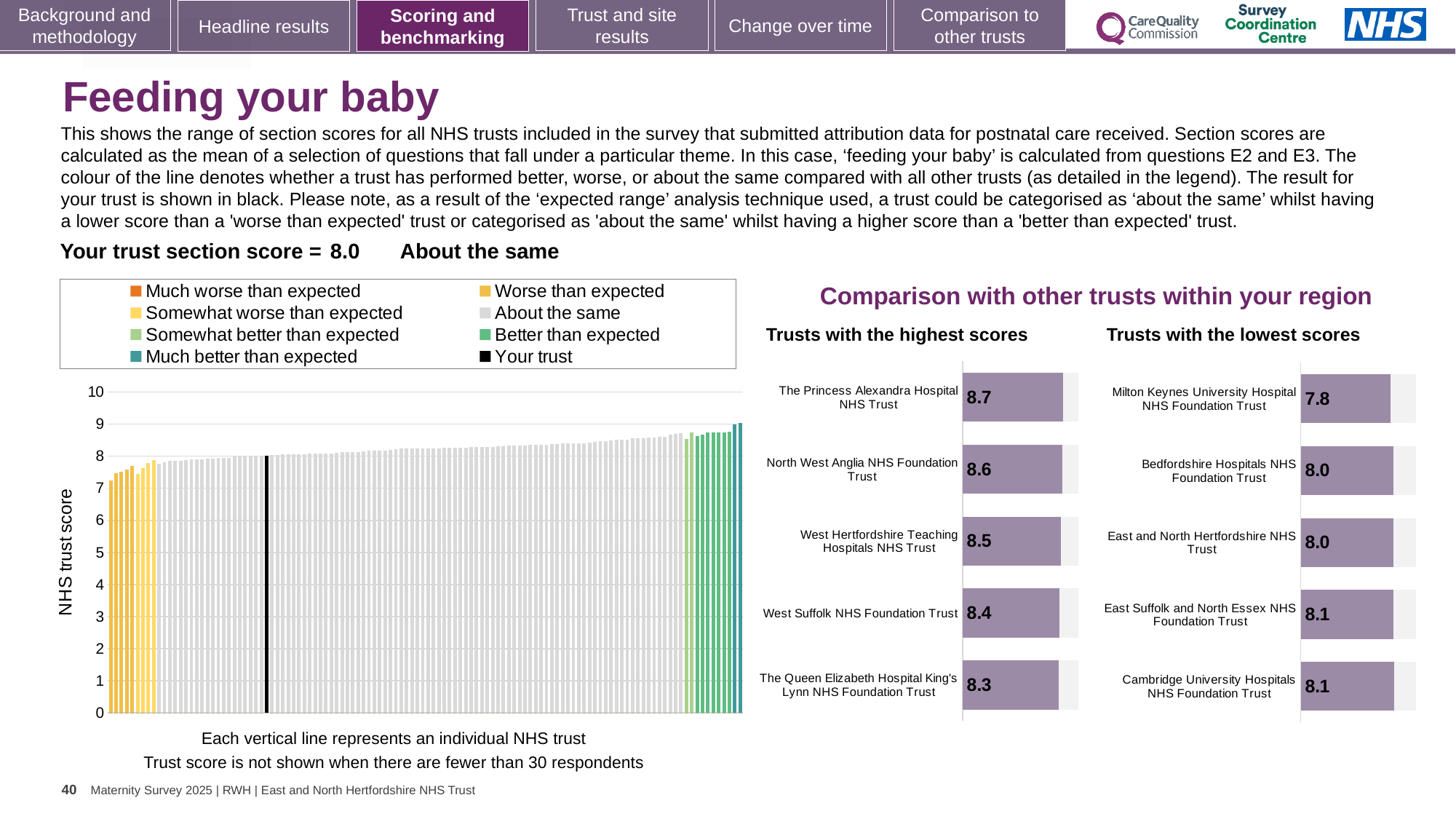
What kind of chart is the NHS trust score chart on the left of the slide? Bar chart In the NHS trust score chart on the left, do the bar heights rise or fall from left to right? Rise In the 'Trusts with the highest scores' chart, what is the difference between the scores of The Princess Alexandra Hospital NHS Trust and The Queen Elizabeth Hospital King's Lynn NHS Foundation Trust? 0.4 How many trusts are listed in the 'Trusts with the lowest scores' chart? 5 In the 'Trusts with the lowest scores' chart, which trust has the lowest score? Milton Keynes University Hospital NHS Foundation Trust In the 'Trusts with the highest scores' chart, what is the score for The Princess Alexandra Hospital NHS Trust? 8.7 In the 'Trusts with the lowest scores' chart, what is the difference between the scores of Cambridge University Hospitals NHS Foundation Trust and Milton Keynes University Hospital NHS Foundation Trust? 0.3 In the NHS trust score chart on the left, is the value of the black 'Your trust' bar greater or less than 5? greater How many entries does the legend of the NHS trust score chart list? 8 In the 'Trusts with the highest scores' chart, which has the higher score: North West Anglia NHS Foundation Trust or West Suffolk NHS Foundation Trust? North West Anglia NHS Foundation Trust In the 'Trusts with the highest scores' chart, which trust has the lowest score shown? The Queen Elizabeth Hospital King's Lynn NHS Foundation Trust In the 'Trusts with the lowest scores' chart, what is the score for Milton Keynes University Hospital NHS Foundation Trust? 7.8